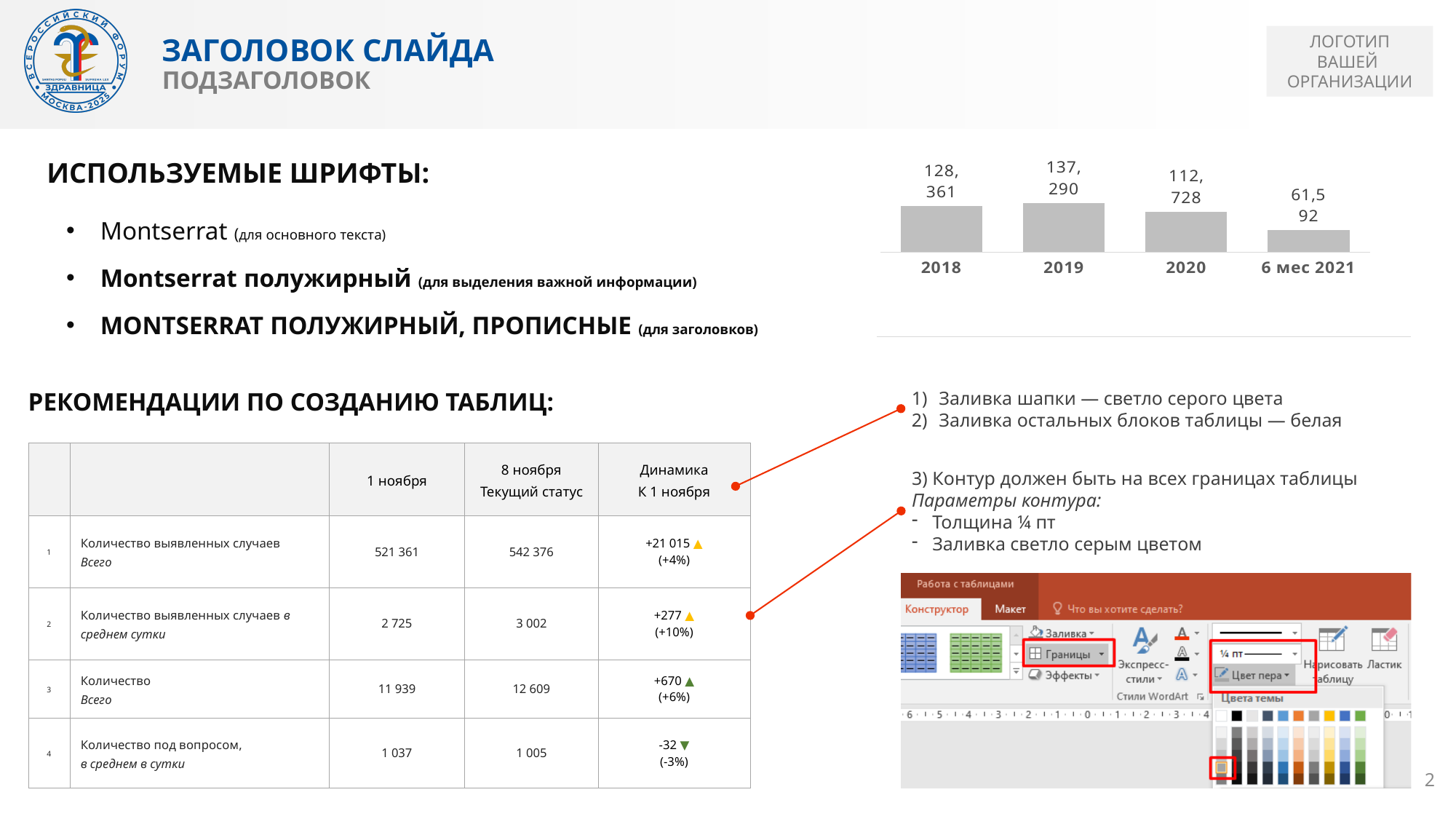
In the bar chart in the top right, what is the difference between the values for 2020 and 6 мес 2021? 51,136 What kind of chart is shown in the top right of the slide? bar chart In the bar chart in the top right, what is the difference between the values for 2019 and 2018? 8,929 In the bar chart in the top right, do the values rise or fall from 2019 to 6 мес 2021? fall In the bar chart in the top right, which category has the highest value? 2019 In the bar chart in the top right, what is the value for 2018? 128,361 In the bar chart in the top right, what is the value for 2020? 112,728 In the bar chart in the top right, which is larger: the value for 2018 or the value for 2020? 2018 In the bar chart in the top right, which category has the lowest value? 6 мес 2021 How many categories does the bar chart in the top right show? 4 In the bar chart in the top right, what is the value for 2019? 137,290 In the bar chart in the top right, what is the value for 6 мес 2021? 61,592